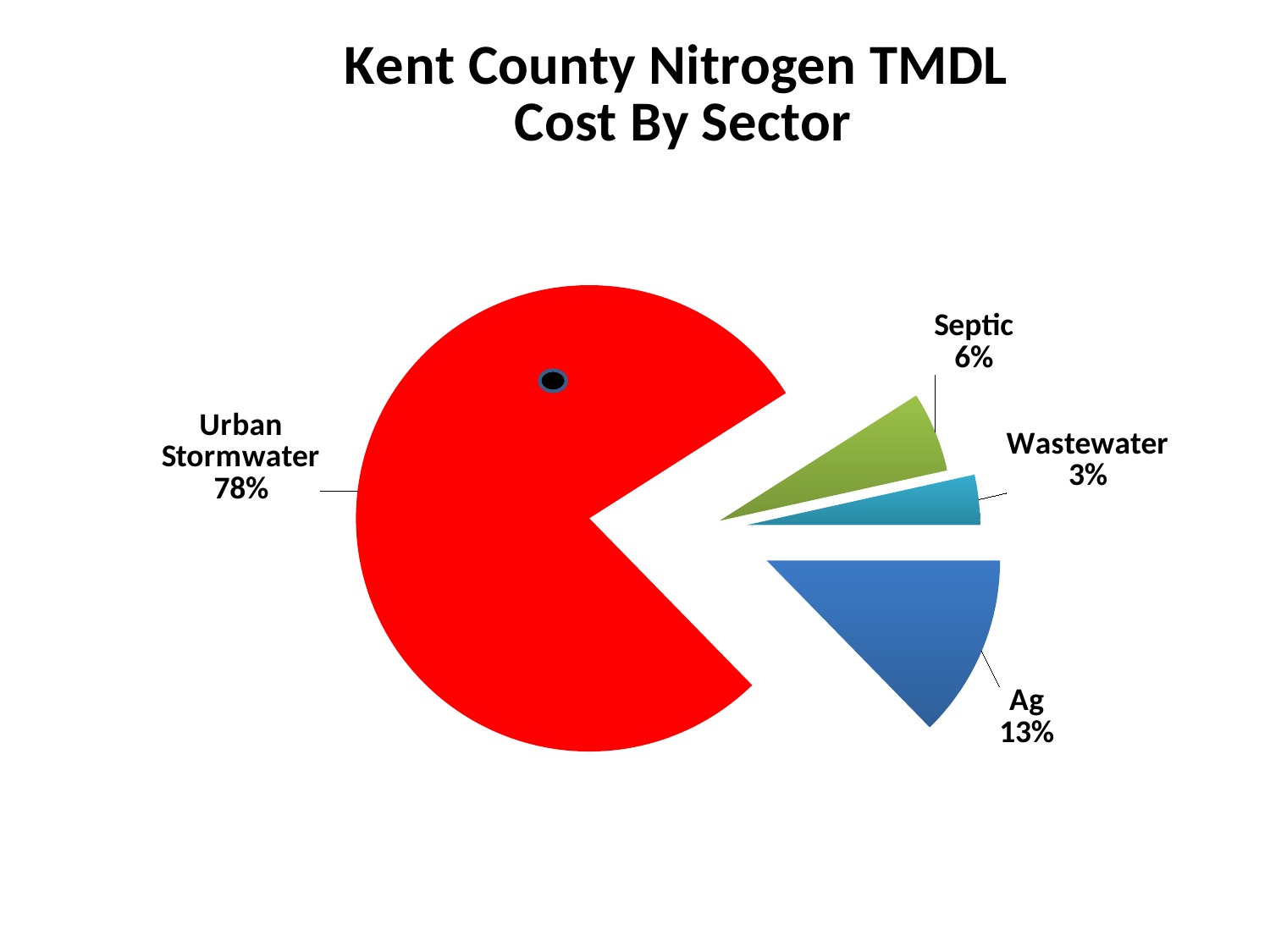
What share of the cost does Urban Stormwater account for? 78% Which has a larger share, Septic or Ag? Ag What share of the cost does Ag account for? 13% What is the difference in percentage points between the Urban Stormwater share and the Ag share? 65 What is the title of the chart? Kent County Nitrogen TMDL Cost By Sector What share of the cost does Septic account for? 6% What is the difference in percentage points between the Septic share and the Wastewater share? 3 Which sector has the smallest share of the cost? Wastewater Which sector has the largest share of the cost? Urban Stormwater What kind of chart is shown on the slide? Pie chart How many sectors are shown in the pie chart? 4 What share of the cost does Wastewater account for? 3%